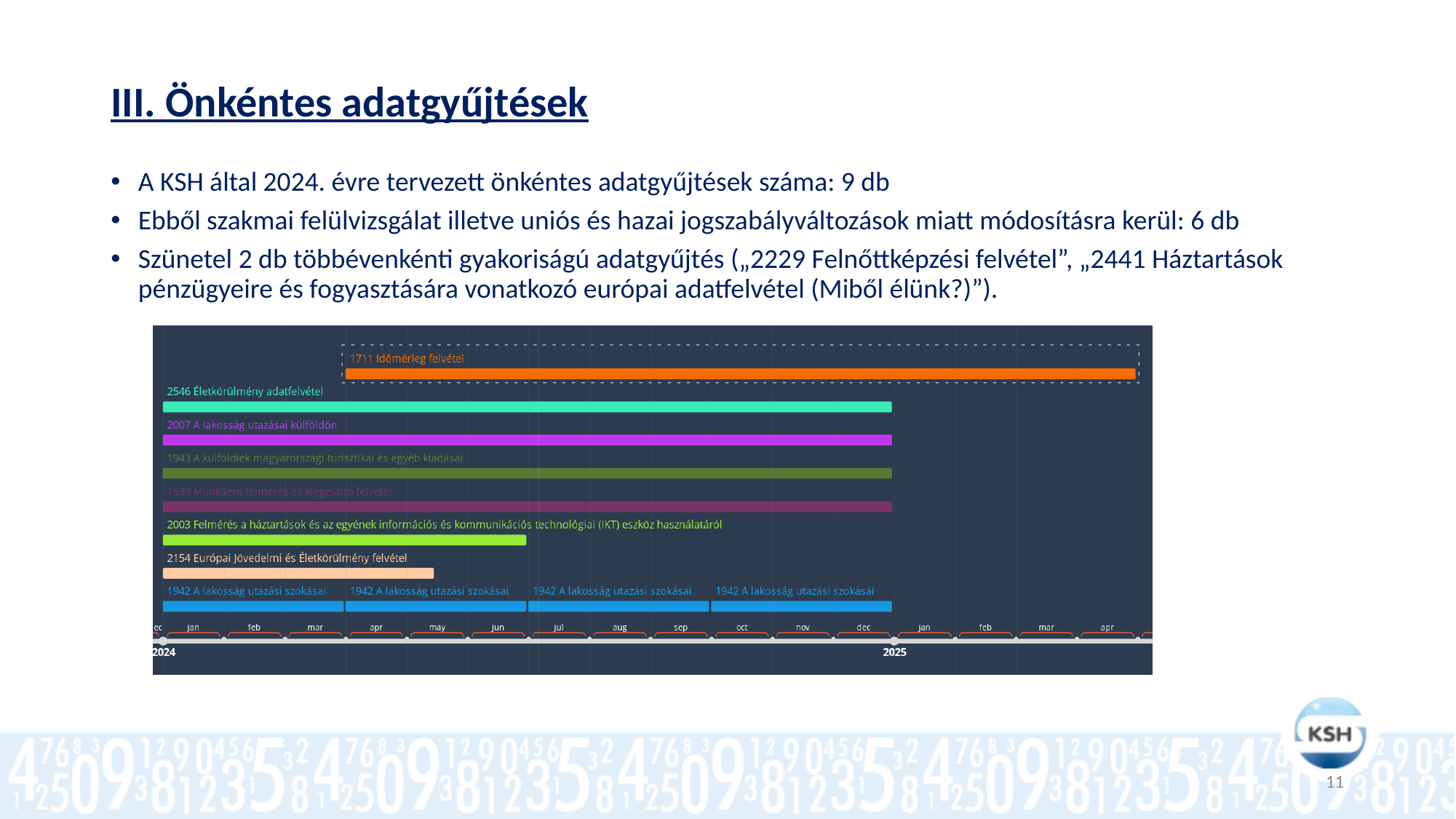
How many separate bars are labelled "1942 A lakosság utazási szokásai" in the chart? 4 Which bar is longer, "2003 Felmérés ... (IKT) eszköz használatáról" or "2154 Európai Jövedelmi és Életkörülmény felvétel"? 2003 Felmérés ... (IKT) eszköz használatáról How many survey rows are shown in the timeline chart? 8 Which survey's bar extends past the 2025 mark on the timeline? 1711 Időmérleg felvétel Which survey's bar starts latest in 2024 on the timeline? 1942 A lakosság utazási szokásai What survey code is shown for "Életkörülmény adatfelvétel"? 2546 Which survey is shown in the bottom row of the timeline chart? 1942 A lakosság utazási szokásai Which two years are marked on the time axis of the chart? 2024 and 2025 What colour is the bar for "1711 Időmérleg felvétel"? Orange Which survey is shown in the top row of the timeline chart? 1711 Időmérleg felvétel What kind of chart is shown on the slide? Gantt chart (timeline) Which bar is longer, "2546 Életkörülmény adatfelvétel" or "2154 Európai Jövedelmi és Életkörülmény felvétel"? 2546 Életkörülmény adatfelvétel